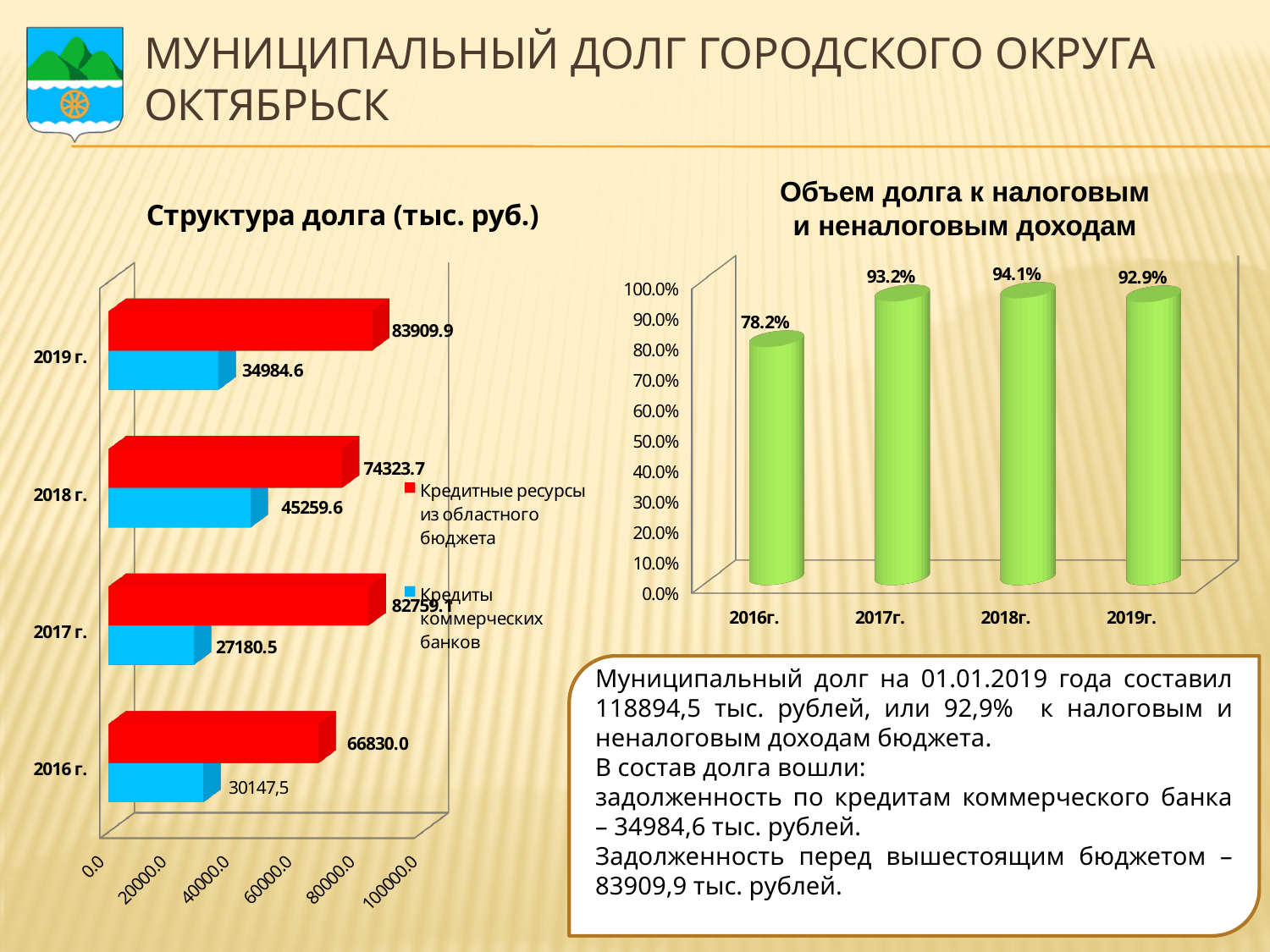
In the chart 'Объем долга к налоговым и неналоговым доходам', how many years are shown? 4 In the chart 'Структура долга (тыс. руб.)', which is larger: 'Кредитные ресурсы из областного бюджета' for 2017 г. or for 2018 г.? 2017 г. In the chart 'Структура долга (тыс. руб.)', how many series does the legend list? 2 What kind of chart is 'Объем долга к налоговым и неналоговым доходам'? bar chart In the chart 'Структура долга (тыс. руб.)', what is the value of 'Кредитные ресурсы из областного бюджета' for 2019 г.? 83909.9 In the chart 'Структура долга (тыс. руб.)', what is the value of 'Кредиты коммерческих банков' for 2016 г.? 30147,5 In the chart 'Структура долга (тыс. руб.)', what is the value of 'Кредиты коммерческих банков' for 2018 г.? 45259.6 In the chart 'Объем долга к налоговым и неналоговым доходам', what is the value for 2016г.? 78.2% In the chart 'Структура долга (тыс. руб.)', what is the difference between 'Кредитные ресурсы из областного бюджета' and 'Кредиты коммерческих банков' for 2018 г.? 29064.1 In the chart 'Объем долга к налоговым и неналоговым доходам', which year has the highest value? 2018г. In the chart 'Структура долга (тыс. руб.)', which year has the lowest value for 'Кредиты коммерческих банков'? 2017 г. In the chart 'Объем долга к налоговым и неналоговым доходам', which year has the lowest value? 2016г.